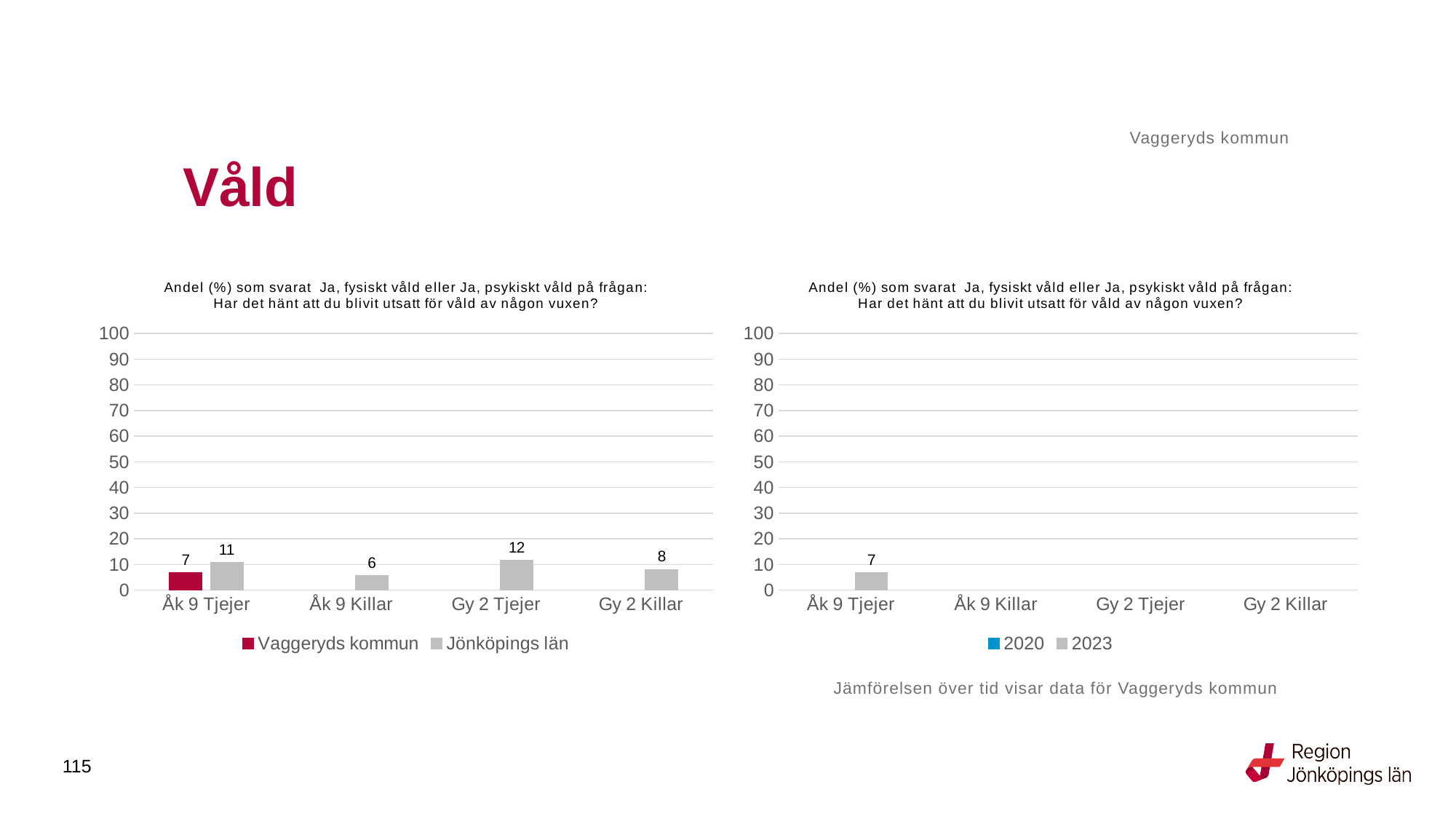
In the left chart, which category has the highest value for Jönköpings län? Gy 2 Tjejer In the left chart, how many series does the legend list? 2 In the right chart, what are the two legend entries? 2020 and 2023 In the left chart, which is larger for Åk 9 Tjejer: Vaggeryds kommun or Jönköpings län? Jönköpings län In the left chart, what is the difference between the Jönköpings län and Vaggeryds kommun values for Åk 9 Tjejer? 4 In the right chart, how many categories are shown on the x axis? 4 In the left chart, which category has the lowest value for Jönköpings län? Åk 9 Killar In the left chart, what is the value for Jönköpings län for Gy 2 Killar? 8 In the right chart, what is the value for 2023 for Åk 9 Tjejer? 7 In the left chart, what is the value for Vaggeryds kommun for Åk 9 Tjejer? 7 What kind of chart is the right chart? Bar chart In the left chart, what is the value for Jönköpings län for Åk 9 Tjejer? 11